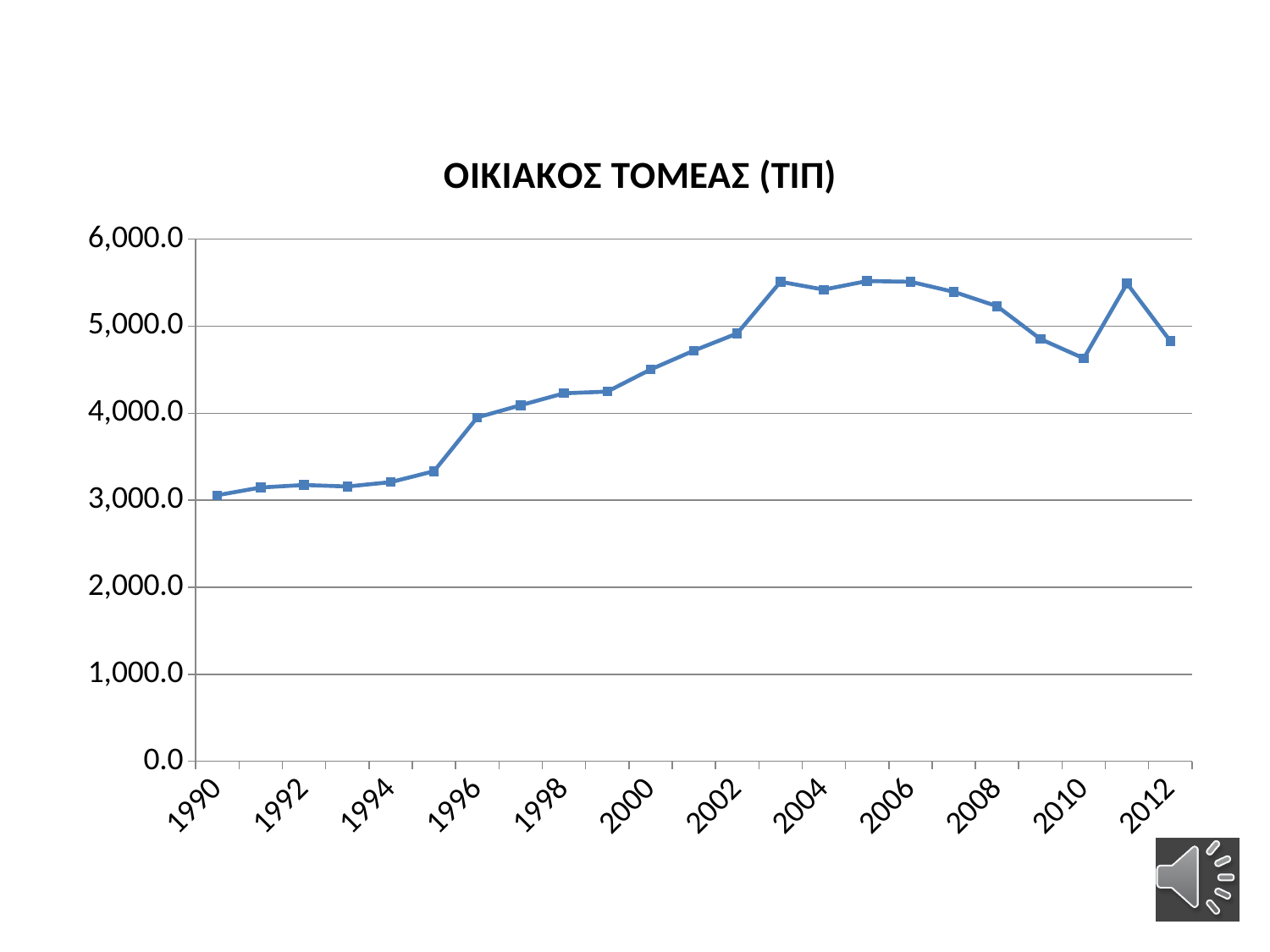
Which year has the larger value, 2003 or 1990? 2003 Which year has the larger value, 2008 or 2010? 2008 Is the value for 2000 greater or less than 4,000.0? greater Is the value for 1990 greater or less than 4,000.0? less How many data points are plotted on the line? 23 Which year has the lowest value on the chart? 1990 How many lines (series) are plotted on the chart? 1 What kind of chart is shown on the slide? line chart What is the title of the chart? ΟΙΚΙΑΚΟΣ ΤΟΜΕΑΣ (ΤΙΠ) Is the value for 2003 greater or less than 5,000.0? greater Do the values generally rise or fall from 1990 to 2003? rise